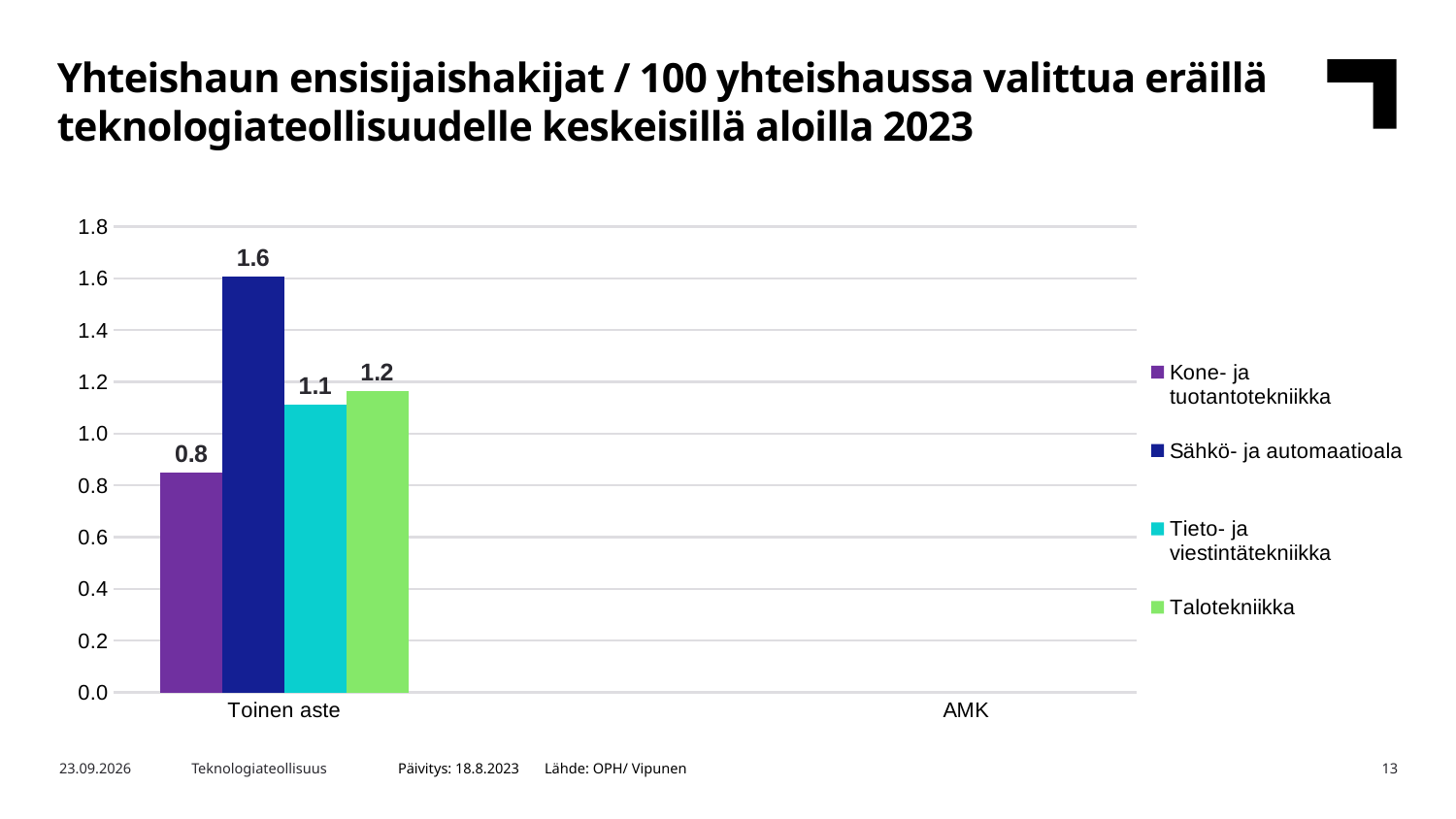
What is the value for Sähkö- ja automaatioala in the Toinen aste category? 1.6 In the Toinen aste category, which is larger: Talotekniikka or Tieto- ja viestintätekniikka? Talotekniikka Which series has the lowest value in the Toinen aste category? Kone- ja tuotantotekniikka What is the value for Tieto- ja viestintätekniikka in the Toinen aste category? 1.1 Which series has the highest value in the Toinen aste category? Sähkö- ja automaatioala What is the value for Talotekniikka in the Toinen aste category? 1.2 How many series does the legend list? 4 What is the difference between the Sähkö- ja automaatioala value and the Kone- ja tuotantotekniikka value in the Toinen aste category? 0.8 Is the value for Kone- ja tuotantotekniikka in the Toinen aste category greater or less than 1.0? less What kind of chart is shown on the slide? Bar chart How many categories are shown on the x axis? 2 What is the value for Kone- ja tuotantotekniikka in the Toinen aste category? 0.8